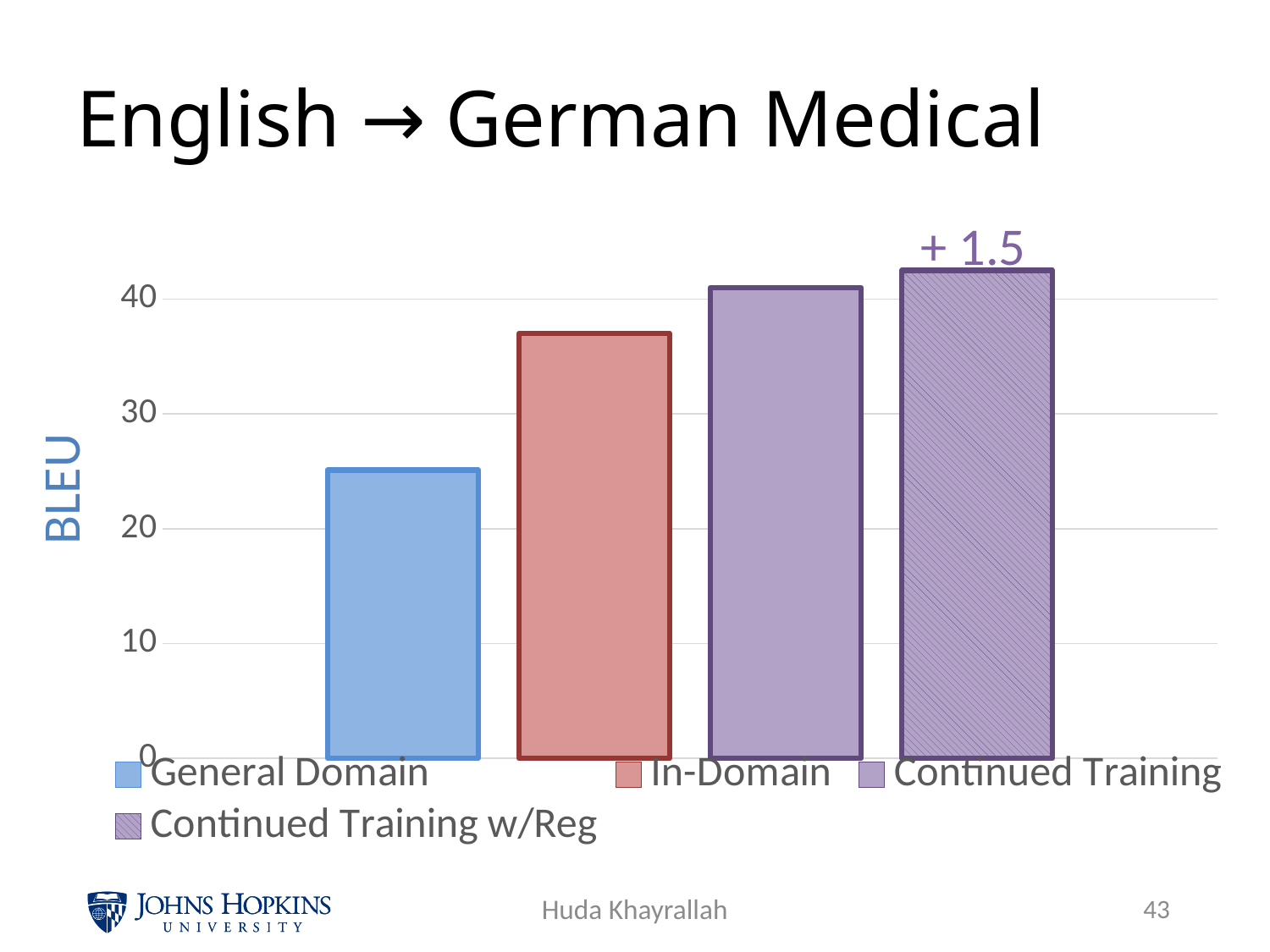
Which series has the highest BLEU score? Continued Training w/Reg Which series has the lowest BLEU score? General Domain Is the BLEU value for General Domain greater or less than 30? less Which has a higher BLEU score, General Domain or In-Domain? In-Domain What is the label on the vertical axis of the chart? BLEU Is the BLEU value for In-Domain greater or less than 30? greater How many series does the legend list? 4 What annotation is printed above the Continued Training w/Reg bar? + 1.5 Which has a higher BLEU score, In-Domain or Continued Training? Continued Training How many bars are plotted in the chart? 4 What kind of chart is shown on the slide? bar chart Is the BLEU value for Continued Training w/Reg greater or less than 40? greater